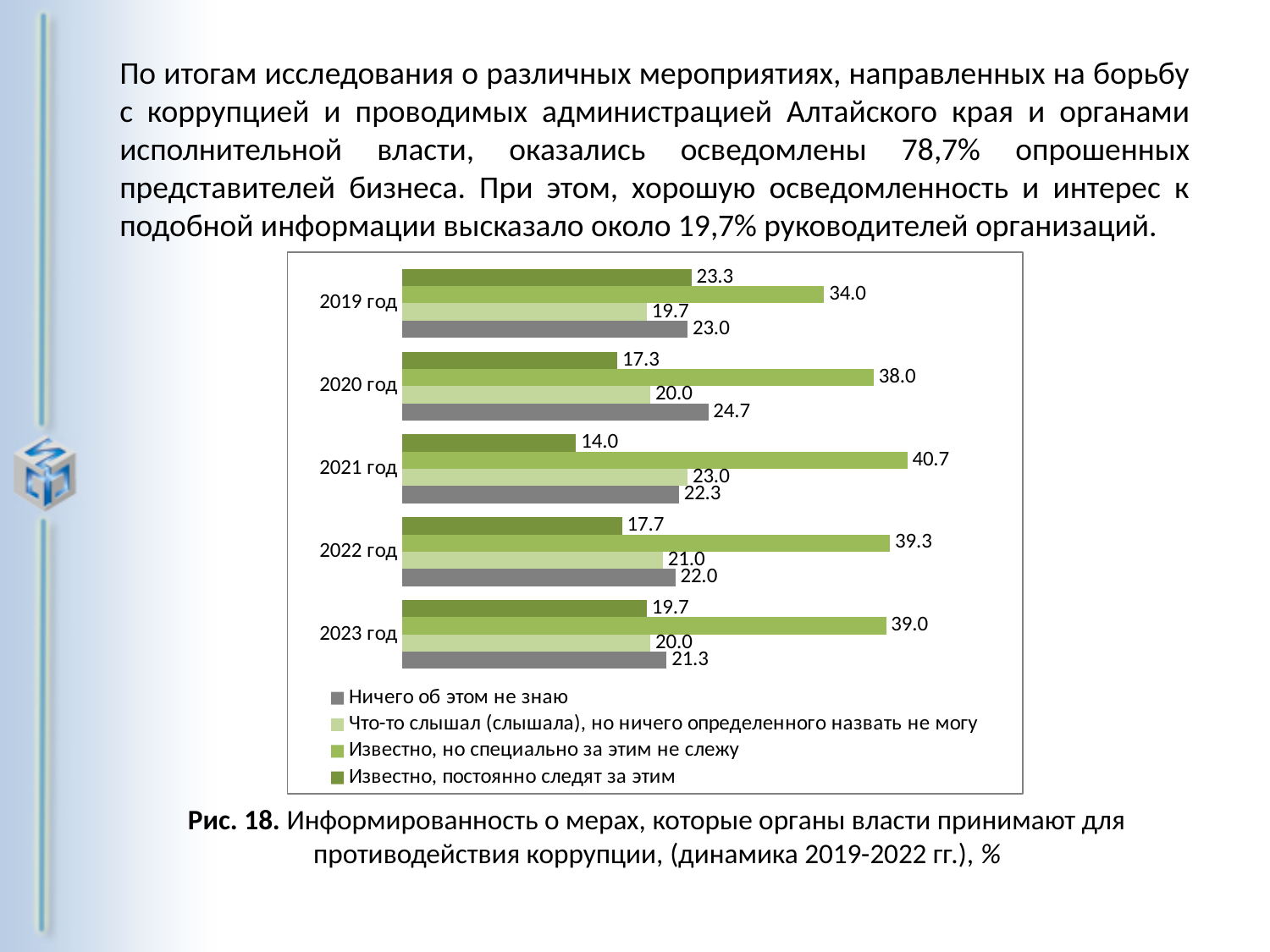
Which series is shown in dark green in the legend? Известно, постоянно следят за этим How many series does the legend list? 4 In which year is the value for "Известно, но специально за этим не слежу" highest? 2021 год What is the value for "Ничего об этом не знаю" in 2020 год? 24.7 What is the value for "Что-то слышал (слышала), но ничего определенного назвать не могу" in 2022 год? 21.0 What is the difference between the "Известно, но специально за этим не слежу" values for 2020 год and 2019 год? 4.0 In which year is the value for "Известно, постоянно следят за этим" lowest? 2021 год Which is larger in 2023 год: "Ничего об этом не знаю" or "Известно, постоянно следят за этим"? Ничего об этом не знаю What is the value for "Известно, постоянно следят за этим" in 2019 год? 23.3 What is the value for "Известно, но специально за этим не слежу" in 2021 год? 40.7 What type of chart is shown on the slide? bar chart How many year categories are shown on the chart? 5